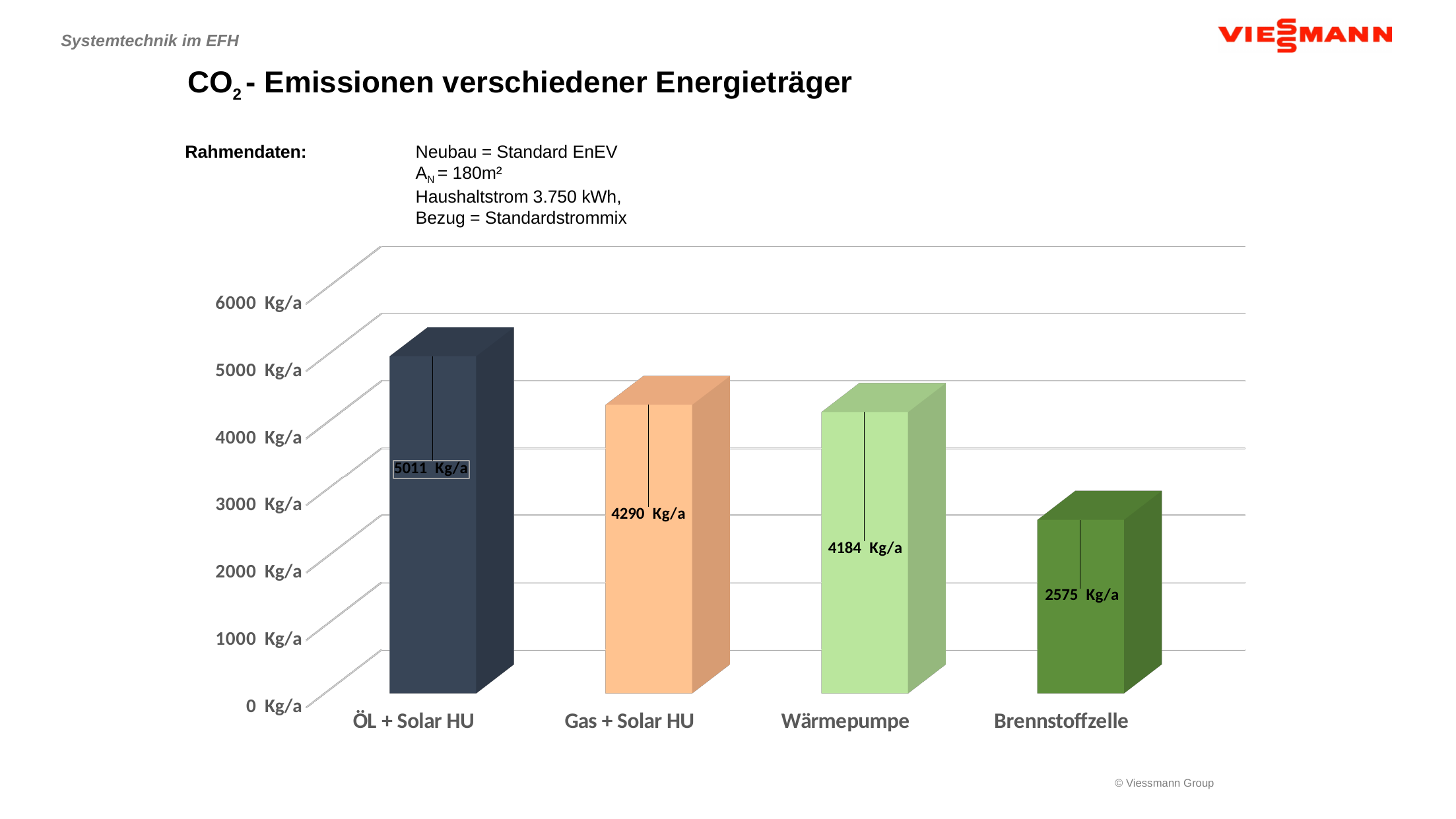
What is the CO2 emission value for ÖL + Solar HU? 5011 Kg/a Which has higher CO2 emissions, Wärmepumpe or Brennstoffzelle? Wärmepumpe What kind of chart is shown on the slide? Bar chart What is the title of the slide's chart? CO2 - Emissionen verschiedener Energieträger How many energy carriers are shown in the chart? 4 Which energy carrier has the lowest CO2 emissions? Brennstoffzelle What is the CO2 emission value for Gas + Solar HU? 4290 Kg/a What is the difference in CO2 emissions between ÖL + Solar HU and Brennstoffzelle? 2436 Kg/a What is the CO2 emission value for Brennstoffzelle? 2575 Kg/a Which energy carrier has the highest CO2 emissions? ÖL + Solar HU What is the difference in CO2 emissions between Gas + Solar HU and Wärmepumpe? 106 Kg/a What is the CO2 emission value for Wärmepumpe? 4184 Kg/a